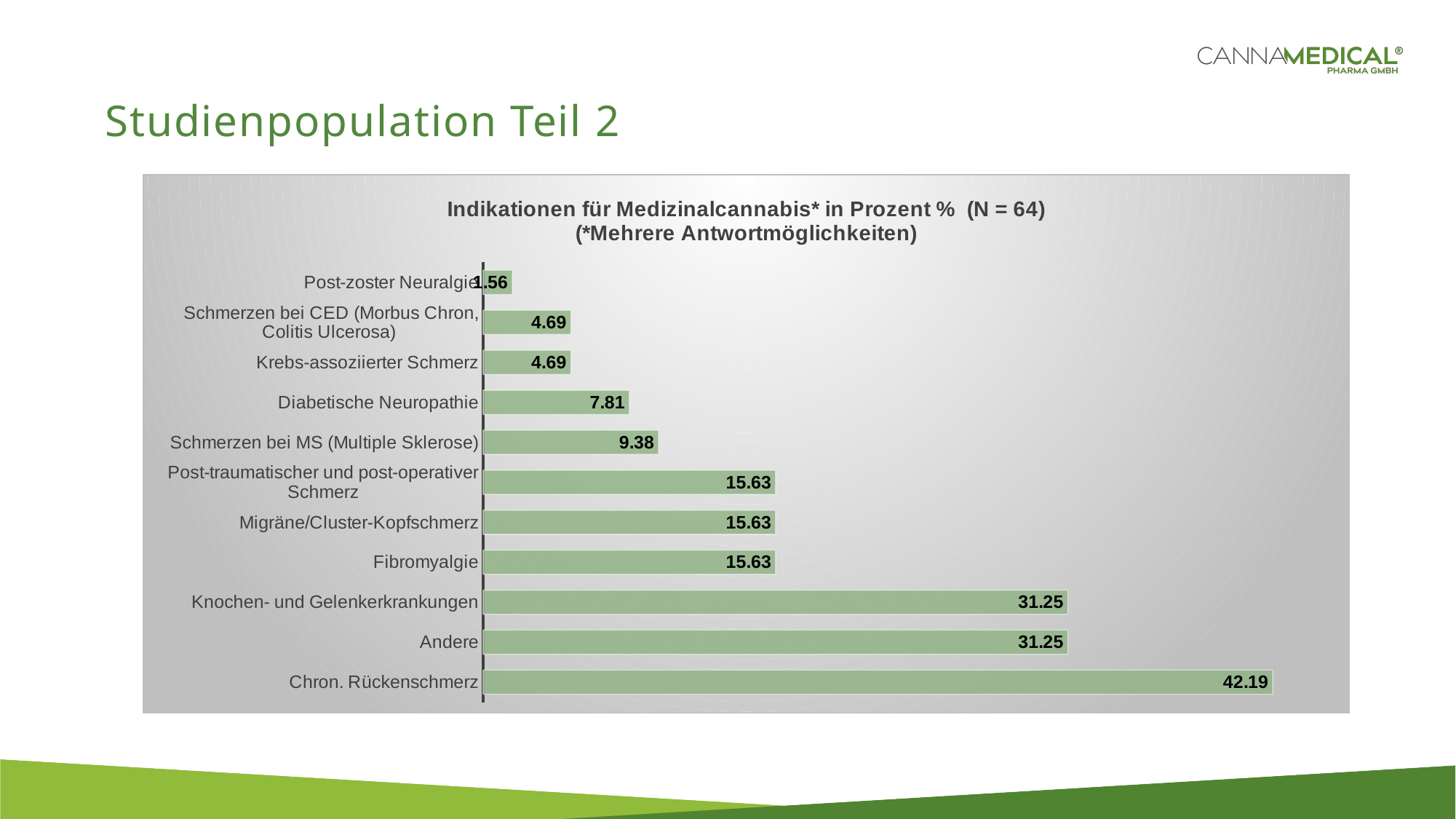
What is the difference between the values for Knochen- und Gelenkerkrankungen and Fibromyalgie? 15.62 What kind of chart is shown on the slide? Bar chart What is the value for Chron. Rückenschmerz? 42.19 Which is larger, the value for Diabetische Neuropathie or the value for Krebs-assoziierter Schmerz? Diabetische Neuropathie What is the value for Diabetische Neuropathie? 7.81 What is the N value stated in the chart title? N = 64 What is the value for Schmerzen bei MS (Multiple Sklerose)? 9.38 Which category has the lowest value? Post-zoster Neuralgie What is the difference between the values for Chron. Rückenschmerz and Andere? 10.94 What is the value for Fibromyalgie? 15.63 Which category has the highest value? Chron. Rückenschmerz How many categories are shown in the chart? 11